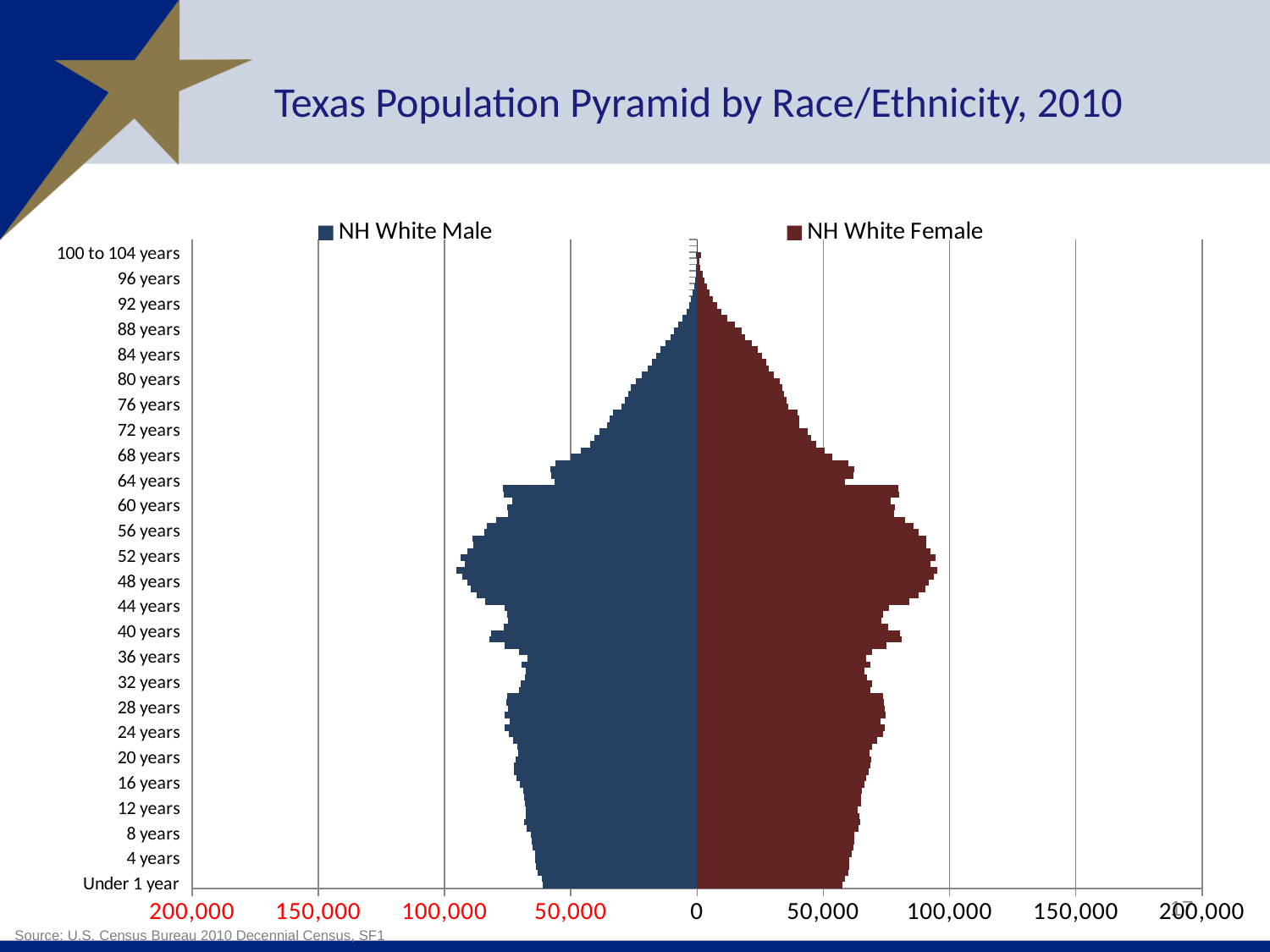
Is the NH White Female value for 80 years greater or less than 50,000? less Is the NH White Female value for 48 years greater or less than 50,000? greater At 84 years, which is larger: the NH White Male value or the NH White Female value? NH White Female How many series does the legend list? 2 What is the title of the chart? Texas Population Pyramid by Race/Ethnicity, 2010 At 88 years, which is larger: the NH White Male value or the NH White Female value? NH White Female Is the NH White Female value for 4 years greater or less than 50,000? greater Which series is shown in dark red on the right side of the pyramid? NH White Female What type of chart is shown on the slide? Bar chart (population pyramid)